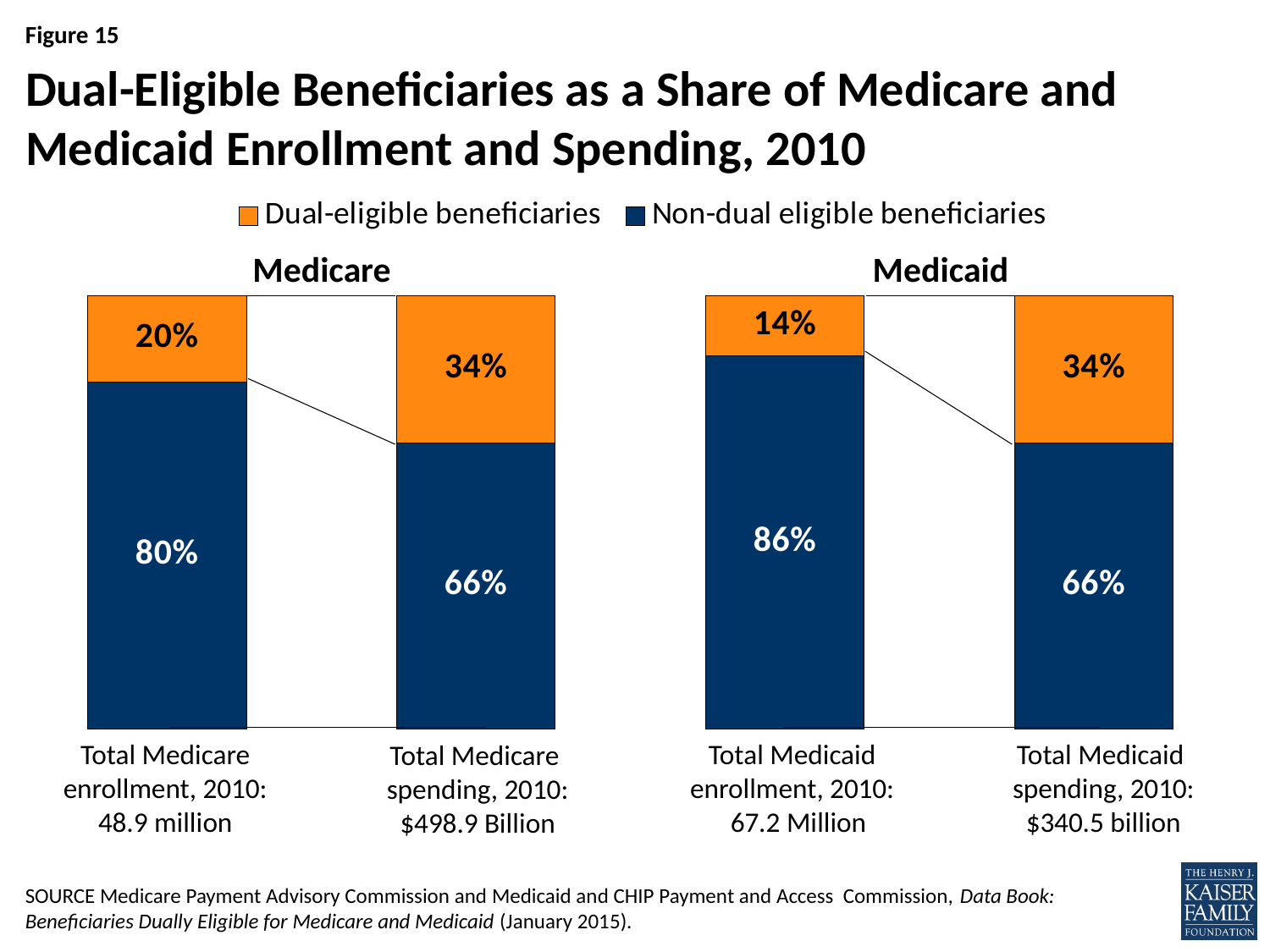
In the Medicaid chart, what is the difference between the dual-eligible share of spending and the dual-eligible share of enrollment? 20 percentage points In the Medicare chart, what share of total Medicare enrollment in 2010 is dual-eligible beneficiaries? 20% What total Medicaid spending amount for 2010 is shown in the Medicaid chart's category label? $340.5 billion In the Medicaid chart, what share of total Medicaid enrollment in 2010 is dual-eligible beneficiaries? 14% How many series does the legend list? 2 In the Medicaid chart, which is larger: the dual-eligible share of enrollment or the dual-eligible share of spending? Dual-eligible share of spending In the Medicare chart, what is the difference between the dual-eligible share of spending and the dual-eligible share of enrollment? 14 percentage points In the Medicare chart, what is the total of the stacked bar for total Medicare spending, 2010? 100% In the Medicare chart, what share of total Medicare enrollment in 2010 is non-dual eligible beneficiaries? 80% In the Medicaid chart, what share of total Medicaid spending in 2010 is non-dual eligible beneficiaries? 66% In the Medicare chart, what share of total Medicare spending in 2010 is dual-eligible beneficiaries? 34% What type of chart is used on this slide? Stacked bar chart